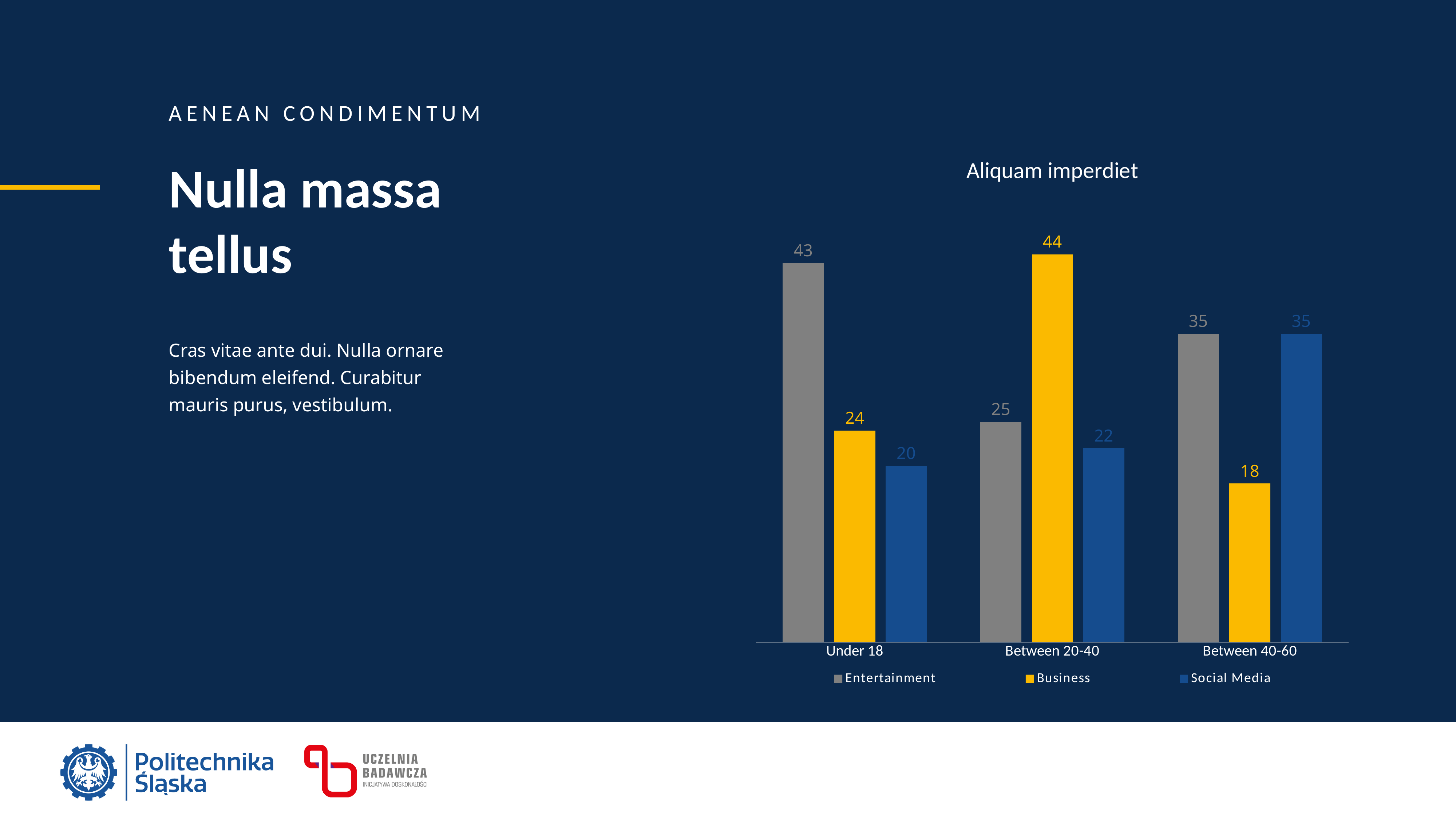
Which category has the lowest Social Media value? Under 18 Do the Entertainment values rise or fall from Under 18 to Between 20-40? Fall Which is larger for Between 20-40: Entertainment or Business? Business What is the title of the chart? Aliquam imperdiet What kind of chart is shown on the slide? Bar chart Which category has the highest Business value? Between 20-40 What is the difference between the Entertainment and Business values for Under 18? 19 How many series does the legend list? 3 What is the Social Media value for Between 20-40? 22 What is the Business value for Between 40-60? 18 How many categories are shown on the x axis? 3 What is the Entertainment value for Under 18? 43